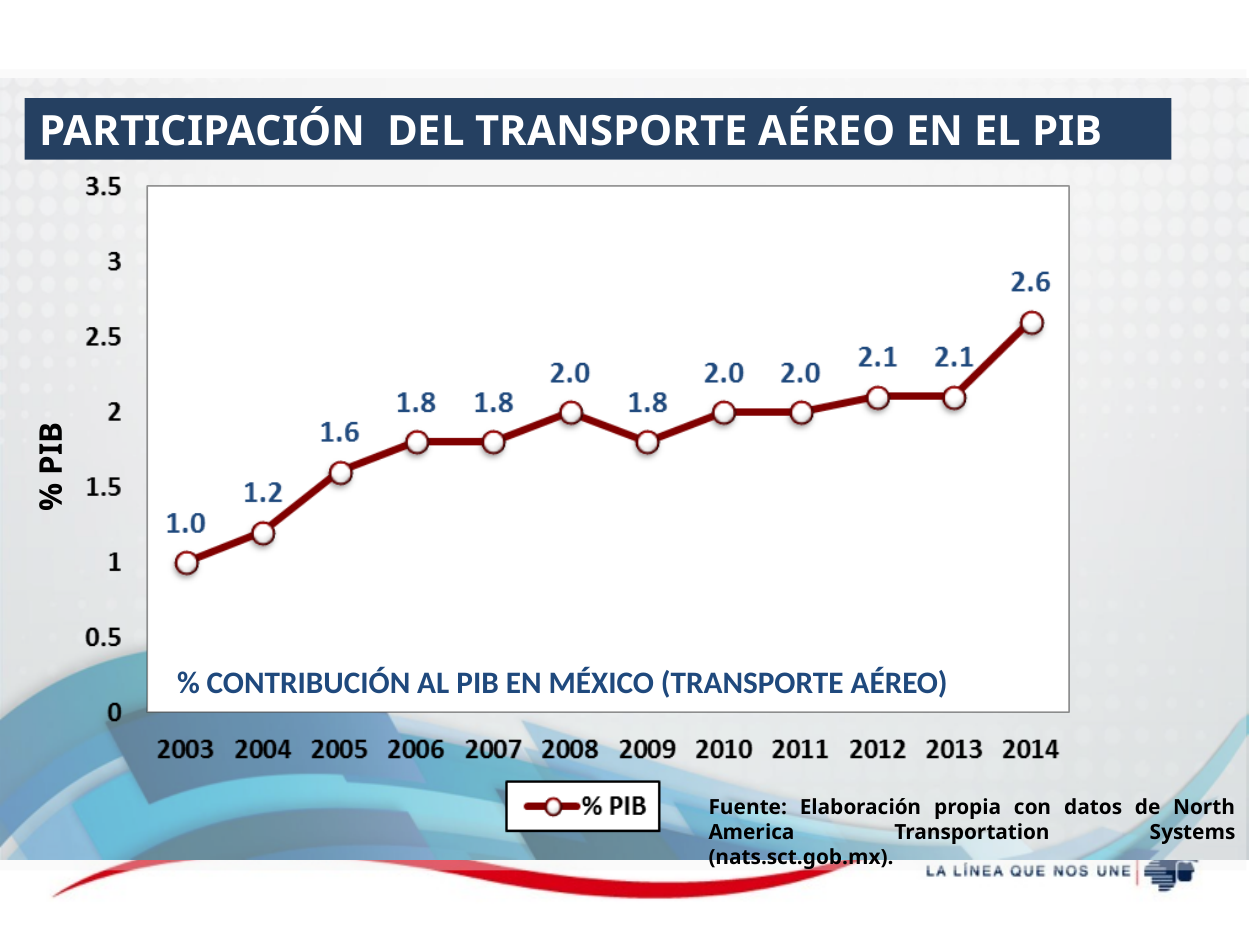
Which year has a larger % PIB value, 2005 or 2008? 2008 What is the % PIB value for 2014? 2.6 Is the value for 2012 greater or less than 2? greater What kind of chart is shown on the slide? Line chart How many series does the legend list? 1 What is the % PIB value for 2009? 1.8 Do the % PIB values generally rise or fall from 2003 to 2014? Rise Which year has the lowest % PIB value? 2003 What is the difference between the % PIB values for 2014 and 2003? 1.6 How many years are plotted on the x axis? 12 Which year has the highest % PIB value? 2014 What is the % PIB value for 2003? 1.0